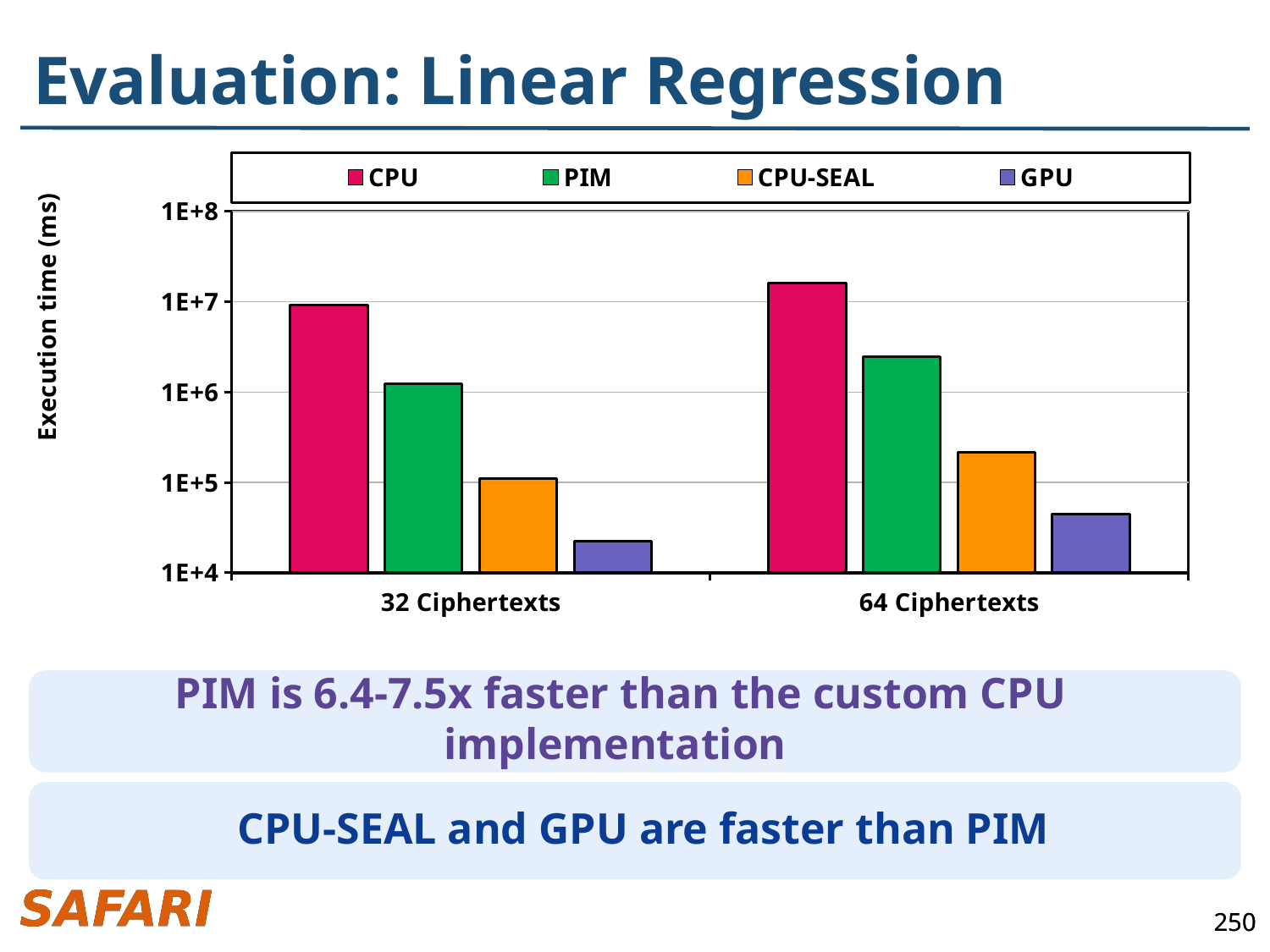
How many series does the legend list? 4 Which series is shown in green in the legend? PIM Is the CPU execution time for 64 Ciphertexts greater or less than 1E+7? greater Does the PIM execution time rise or fall from 32 Ciphertexts to 64 Ciphertexts? rise Which series has the highest execution time for 32 Ciphertexts? CPU Which has the larger execution time for 64 Ciphertexts, PIM or CPU-SEAL? PIM What kind of chart is shown on the slide? bar chart How many categories are shown on the x axis? 2 Is the PIM execution time for 64 Ciphertexts greater or less than 1E+6? greater Is the GPU execution time for 32 Ciphertexts greater or less than 1E+5? less Which series has the lowest execution time for 64 Ciphertexts? GPU What is the label of the y axis? Execution time (ms)